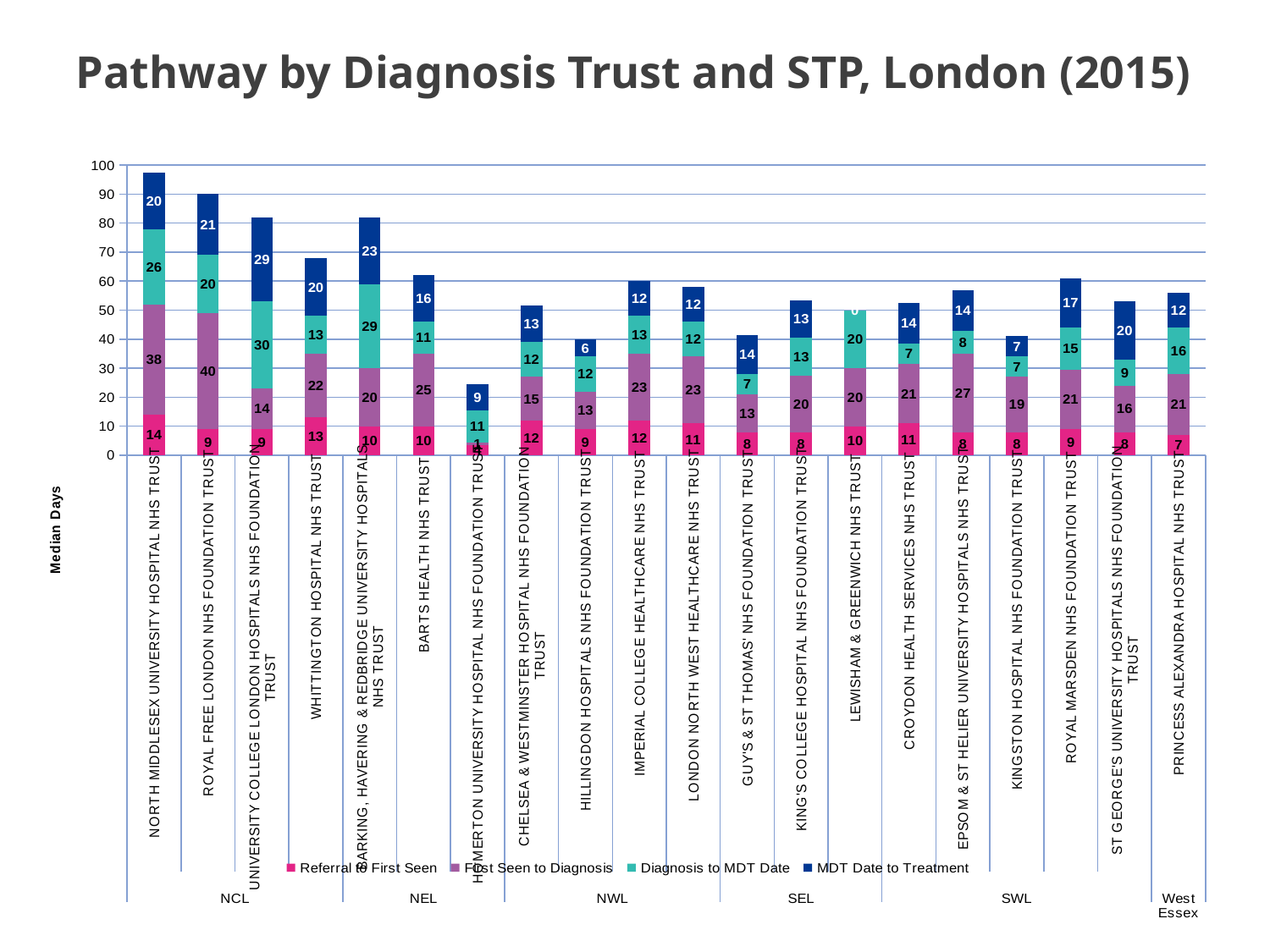
What is the difference in First Seen to Diagnosis between Epsom & St Helier University Hospitals NHS Trust and Kingston Hospital NHS Foundation Trust? 8 Which has the larger MDT Date to Treatment value: University College London Hospitals NHS Foundation Trust or Barking, Havering & Redbridge University Hospitals NHS Trust? University College London Hospitals NHS Foundation Trust What is the total of the stacked bar for North Middlesex University Hospital NHS Trust? 98 What is the total of the stacked bar for Barts Health NHS Trust? 62 How many series does the legend list? 4 What is the First Seen to Diagnosis value for Royal Free London NHS Foundation Trust? 40 How many trusts are plotted along the x axis? 20 Which trust has the highest total median days? North Middlesex University Hospital NHS Trust What is the MDT Date to Treatment value for University College London Hospitals NHS Foundation Trust? 29 Which trust has the lowest total median days? Homerton University Hospital NHS Foundation Trust What is the Diagnosis to MDT Date value for Barking, Havering & Redbridge University Hospitals NHS Trust? 29 What kind of chart is shown on the slide? Stacked bar chart